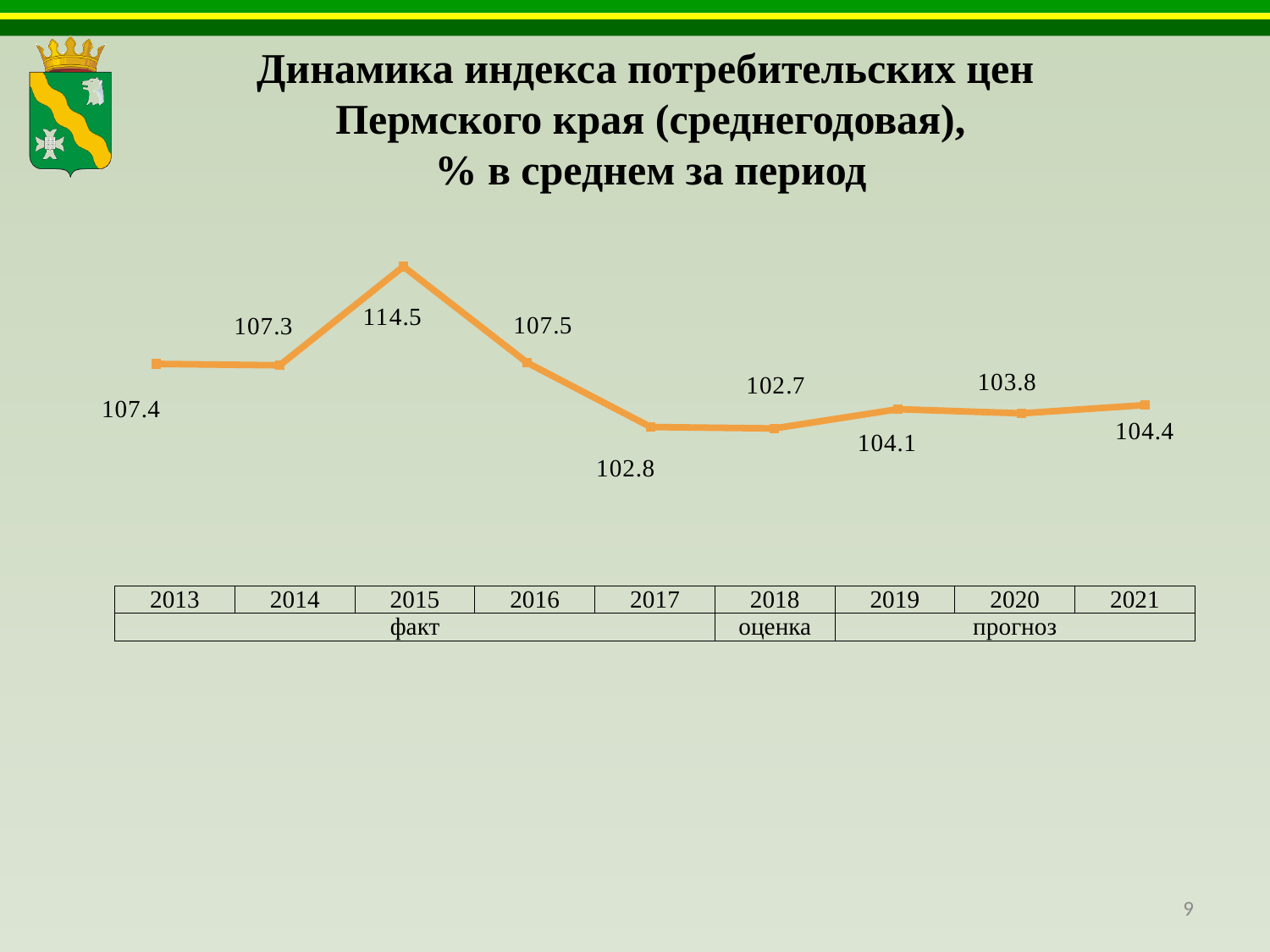
What is the difference between the values for 2019 and 2020? 0.3 What kind of chart is shown on the slide? line chart Which year has the highest consumer price index value? 2015 Do the values rise or fall from 2015 to 2018? fall What is the consumer price index value for 2021? 104.4 Which is larger, the value for 2016 or the value for 2017? 2016 What is the consumer price index value for 2015? 114.5 Which year has the lowest consumer price index value? 2018 What is the consumer price index value for 2018? 102.7 What is the difference between the values for 2015 and 2016? 7.0 How many years are plotted on the chart? 9 What is the consumer price index value for 2013? 107.4